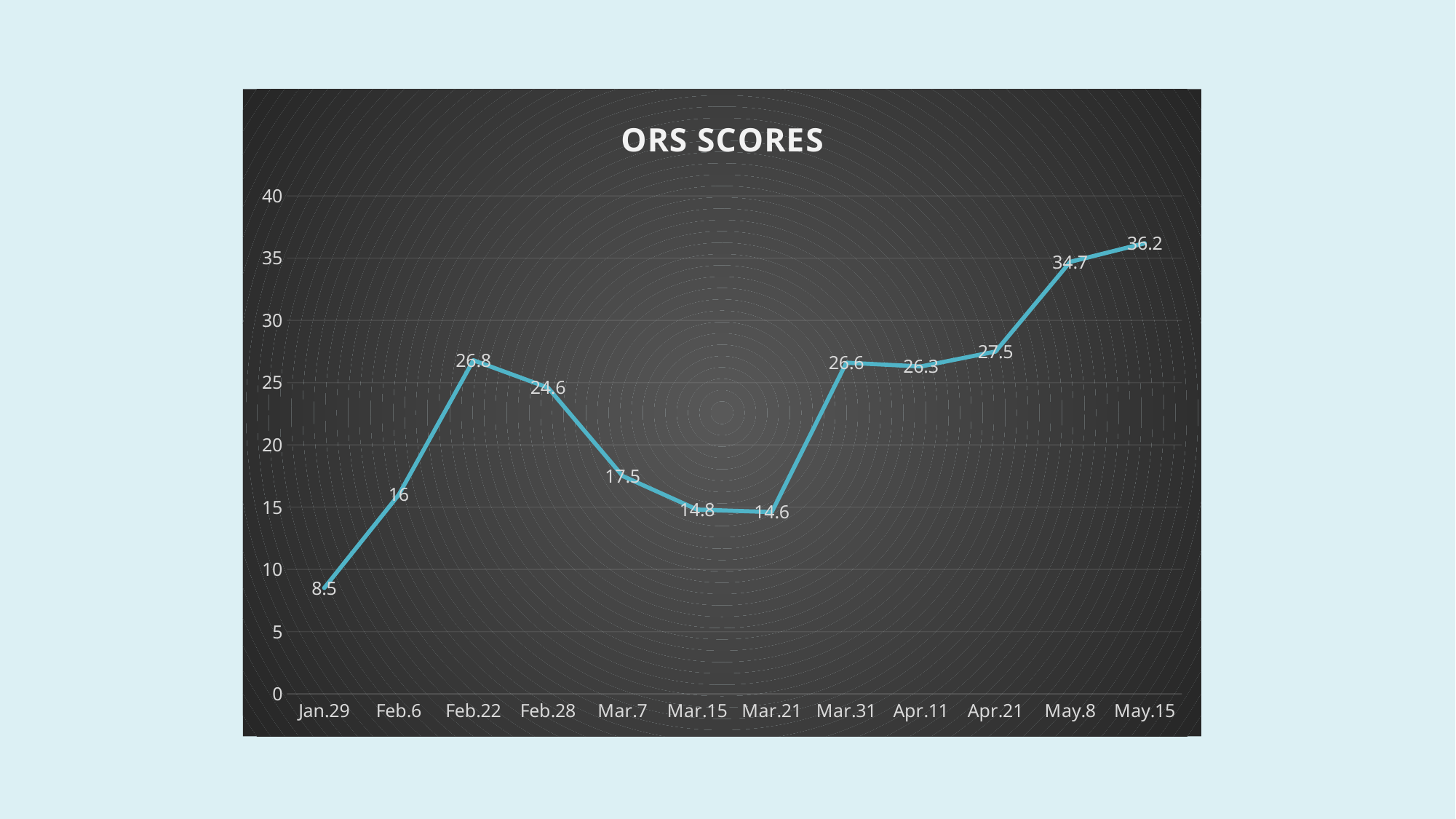
Is the ORS score on Apr.21 greater or less than 25? greater Which is larger, the ORS score on Feb.6 or on Mar.7? Mar.7 What is the title of the chart? ORS SCORES How many dates are plotted on the chart? 12 What is the difference between the ORS scores on Feb.22 and Feb.28? 2.2 What is the ORS score on May.8? 34.7 Which date has the lowest ORS score? Jan.29 What is the difference between the ORS scores on May.15 and Jan.29? 27.7 Which date has the highest ORS score? May.15 What kind of chart is shown on the slide? line chart What is the ORS score on Jan.29? 8.5 What is the ORS score on Mar.21? 14.6